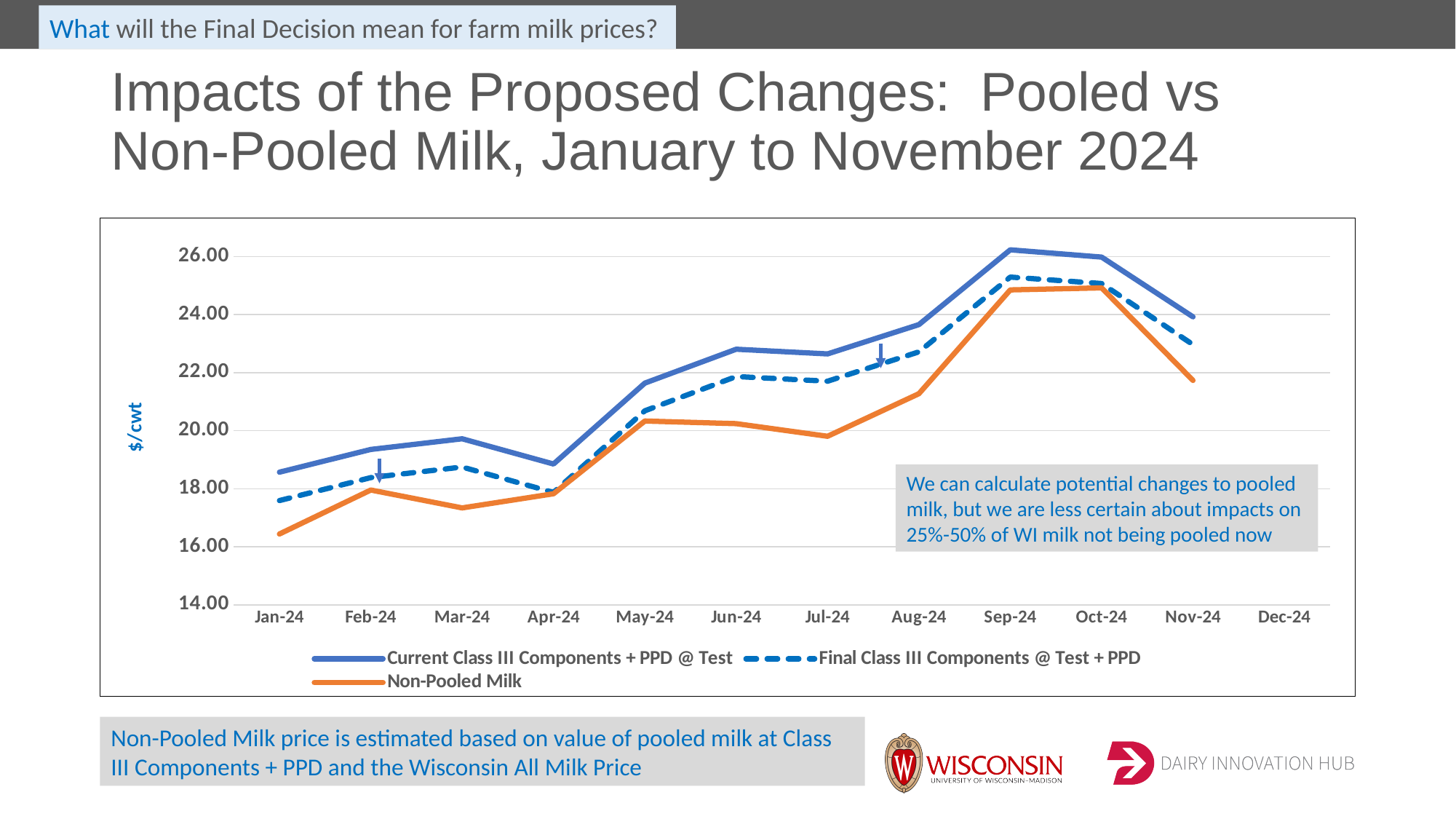
Which series in the legend is drawn as a dashed line? Final Class III Components @ Test + PPD What kind of chart is shown on the slide? line chart In Jan-24, which is higher: Current Class III Components + PPD @ Test or Non-Pooled Milk? Current Class III Components + PPD @ Test Is the Final Class III Components @ Test + PPD value for Apr-24 greater or less than 20.00? less Does the Non-Pooled Milk series rise or fall from Oct-24 to Nov-24? fall How many series does the chart legend list? 3 Is the Non-Pooled Milk value for Jan-24 greater or less than 18.00? less Is the Current Class III Components + PPD @ Test value for Jun-24 greater or less than 22.00? greater What is the label on the y axis of the chart? $/cwt How many month labels appear on the x axis of the chart? 12 In which month is the Non-Pooled Milk series at its lowest? Jan-24